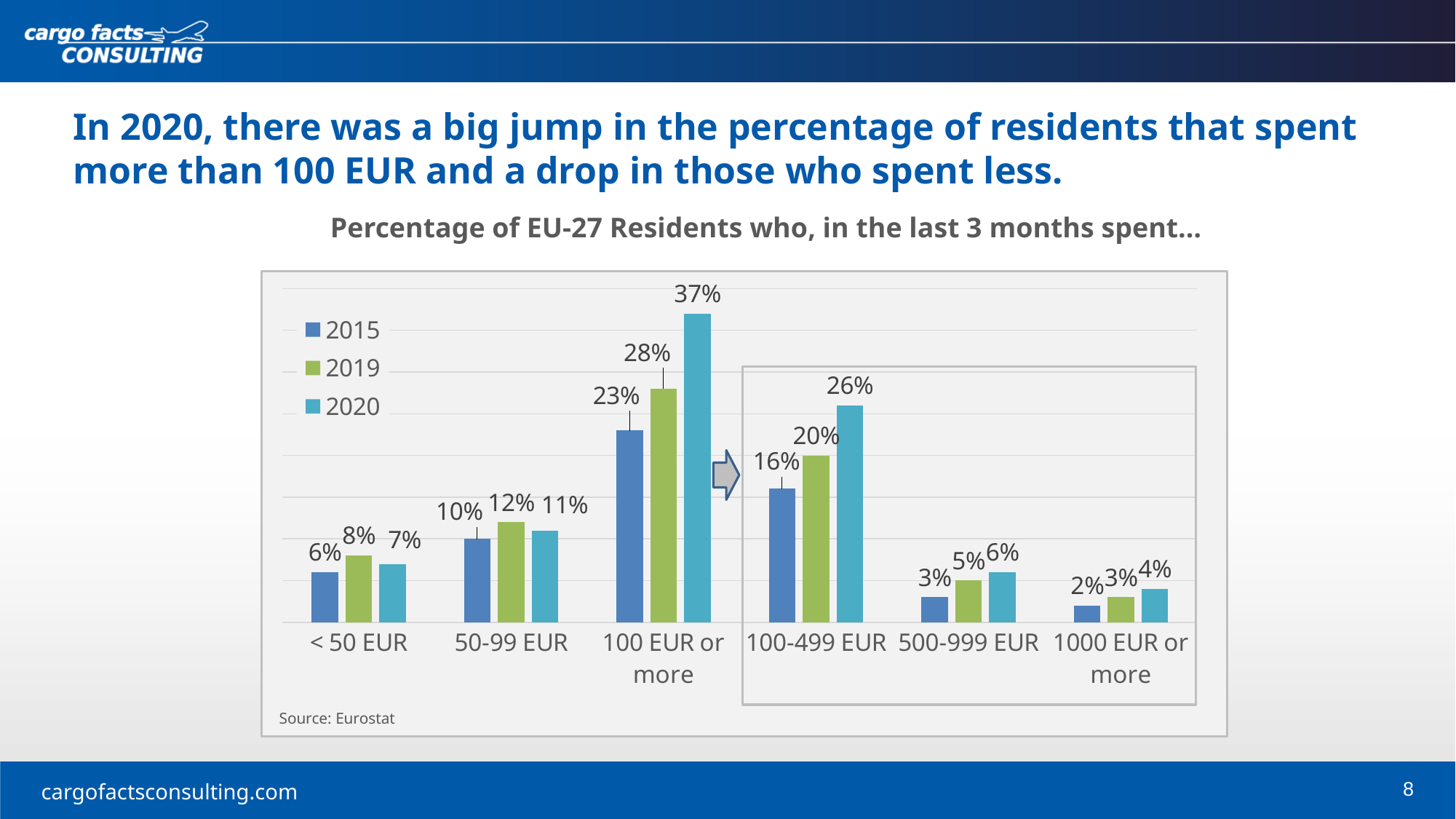
What is the difference between the 2015 and 2020 values for the 100-499 EUR category? 10% What percentage of EU-27 residents spent 100 EUR or more in 2020? 37% What percentage of EU-27 residents spent less than 50 EUR in 2015? 6% How many spending categories are shown on the x axis? 6 What type of chart is shown on the slide? Bar chart For the 50-99 EUR category, which year has the larger value, 2019 or 2020? 2019 What percentage of EU-27 residents spent 1000 EUR or more in 2020? 4% By how many percentage points did the share of residents spending 100 EUR or more increase from 2019 to 2020? 9% How many years (series) does the legend list? 3 Which spending category has the highest value for 2020? 100 EUR or more Which spending category has the lowest value for 2015? 1000 EUR or more What percentage of EU-27 residents spent 100-499 EUR in 2019? 20%